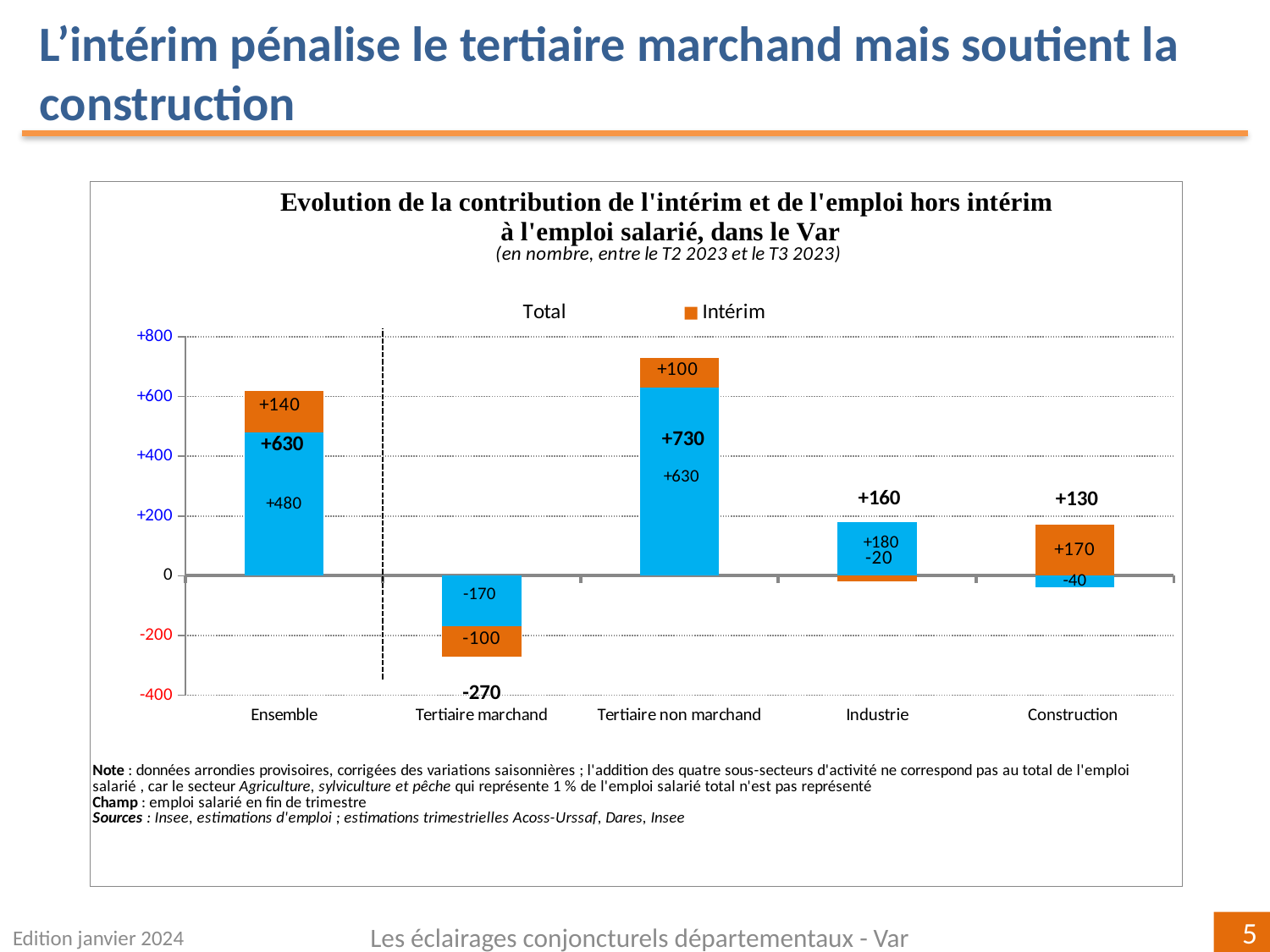
What is the total value labelled for Tertiaire non marchand? +730 Which has the larger Intérim value, Construction or Tertiaire non marchand? Construction What is the Intérim value for Ensemble? +140 Which two entries does the chart legend list? Total and Intérim What is the Intérim value for Construction? +170 Which category has the lowest total value? Tertiaire marchand Which category has the highest total value? Tertiaire non marchand What is the Intérim value for Tertiaire marchand? -100 How many sector categories are shown on the x axis of the chart? 5 What is the difference between the total values for Industrie (+160) and Construction (+130)? 30 What is the value of the blue segment for Industrie? +180 What kind of chart is shown on the slide? bar chart